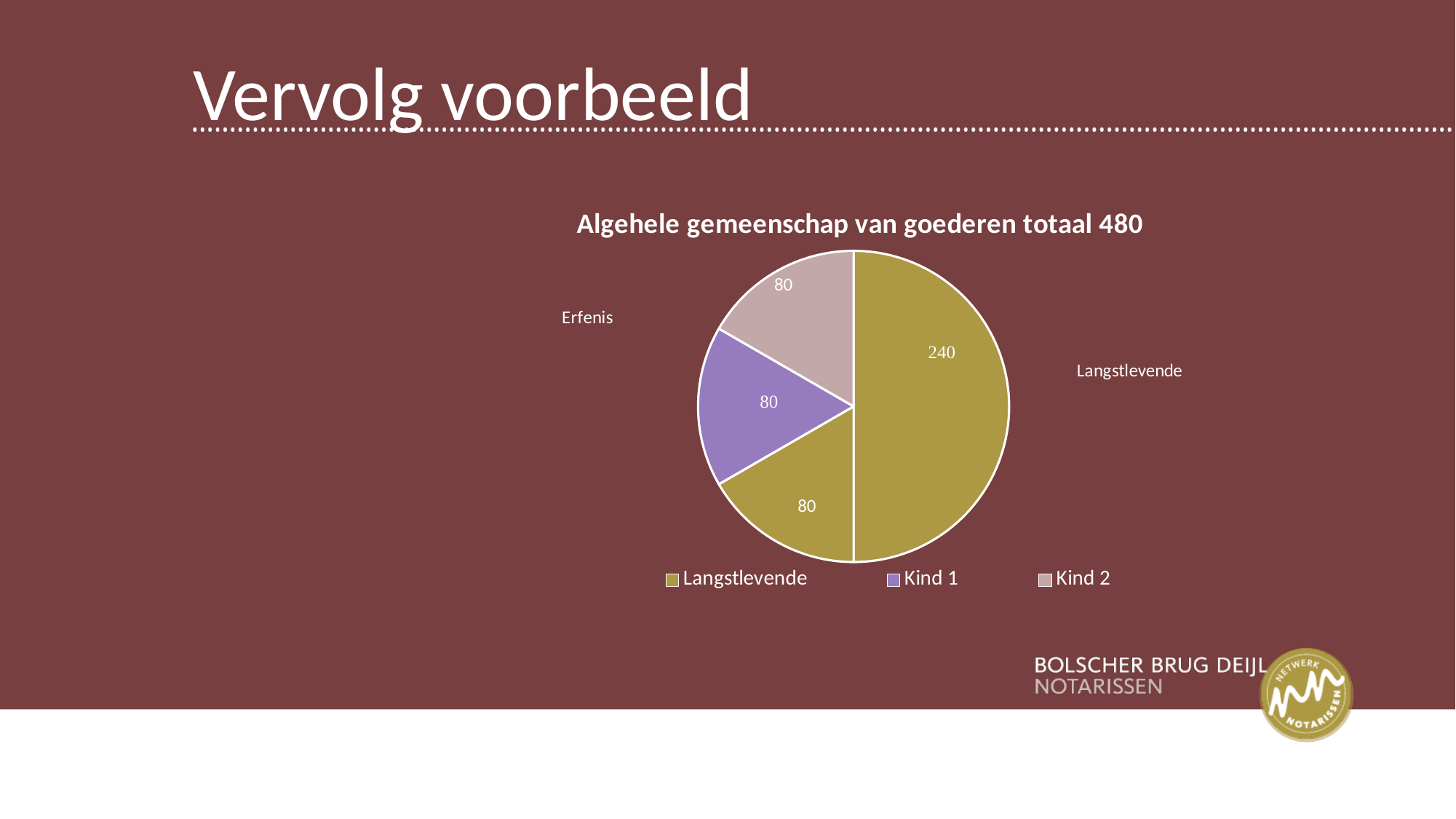
What is the value of the purple Kind 1 slice? 80 How many entries does the chart legend list? 3 What is the value of the largest slice of the pie chart? 240 Which is larger, the slice labelled 240 or the Kind 2 slice labelled 80? The slice labelled 240 What is the value of the pink Kind 2 slice? 80 What is the total of all slices in the pie chart, as stated in the title? 480 What kind of chart is shown on the slide? Pie chart Which legend entry is shown in purple? Kind 1 How many slices does the pie chart have? 4 What is the title of the chart? Algehele gemeenschap van goederen totaal 480 What is the difference between the largest slice (240) and the Kind 1 slice (80)? 160 What share of the pie does the slice labelled 240 represent, given the total of 480? 50%